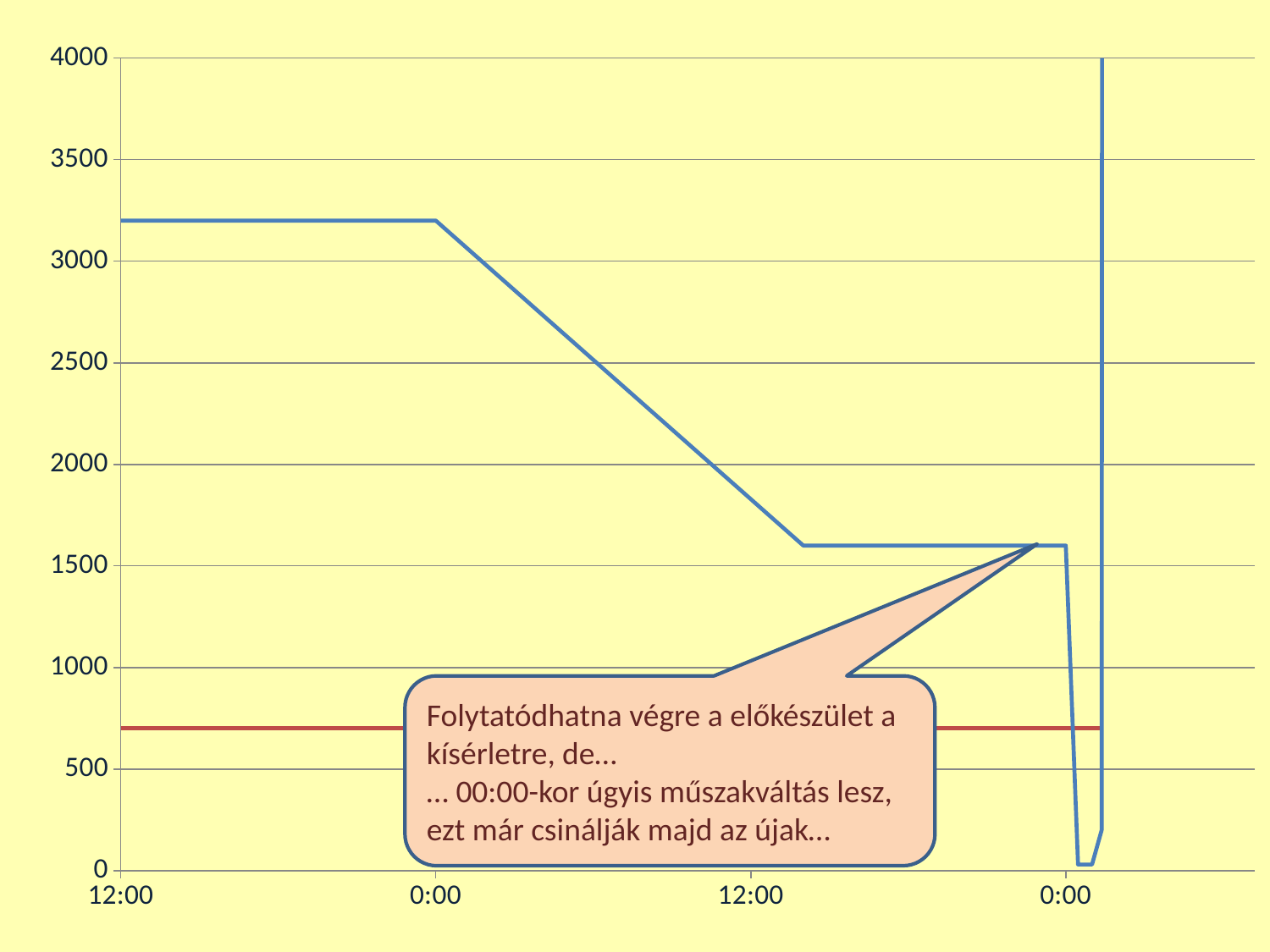
How many time labels are shown on the x axis? 4 Is the value of the blue line at the second 12:00 tick greater or less than 2000? less Is the value of the red line greater or less than 1000? less Does the blue line rise or fall between the first 0:00 tick and the second 12:00 tick? fall What kind of chart is shown on the slide? line chart Is the value of the red line greater or less than 500? greater Does the red line rise, fall, or stay flat across the x axis? stay flat What is the highest value shown on the vertical axis? 4000 How many lines are plotted on the chart? 2 At the first 12:00 tick, which line has the larger value, the blue line or the red line? the blue line